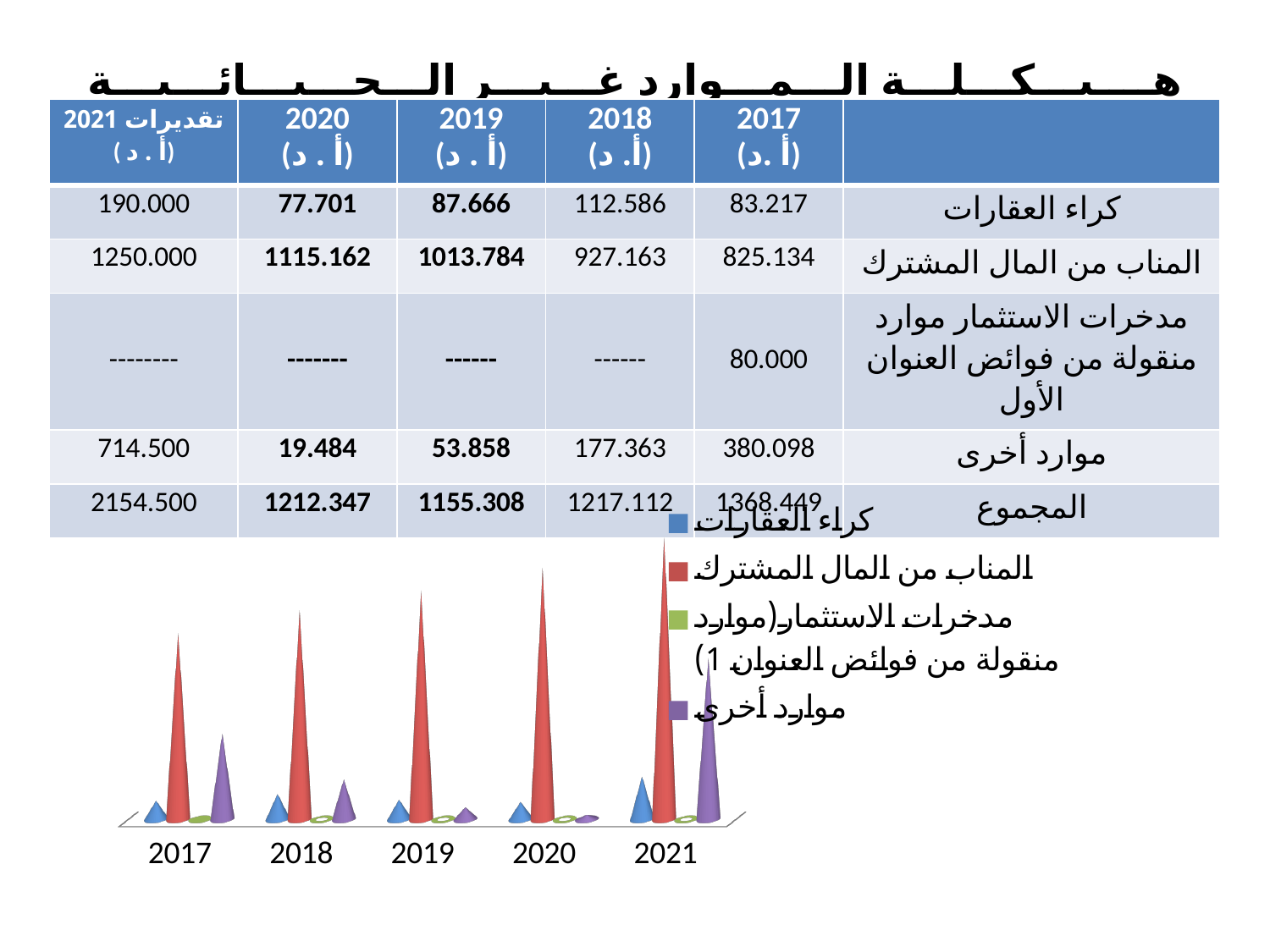
Which series has the tallest bar in 2021? المناب من المال المشترك How many series does the chart's legend list? 4 Does the series المناب من المال المشترك rise or fall from 2017 to 2021? rises Is the bar for كراء العقارات taller in 2020 or in 2021? 2021 What kind of chart is shown below the table on the slide? bar chart What is the first entry in the chart's legend? كراء العقارات Is the bar for موارد أخرى taller in 2020 or in 2021? 2021 In 2017, which is taller: the bar for كراء العقارات or the bar for موارد أخرى? موارد أخرى How many years are shown along the x axis of the chart? 5 In which year is the bar for موارد أخرى the tallest? 2021 What colour represents المناب من المال المشترك in the chart? red Which series has the lowest bar in 2020? مدخرات الاستثمار(موارد منقولة من فوائض العنوان 1)